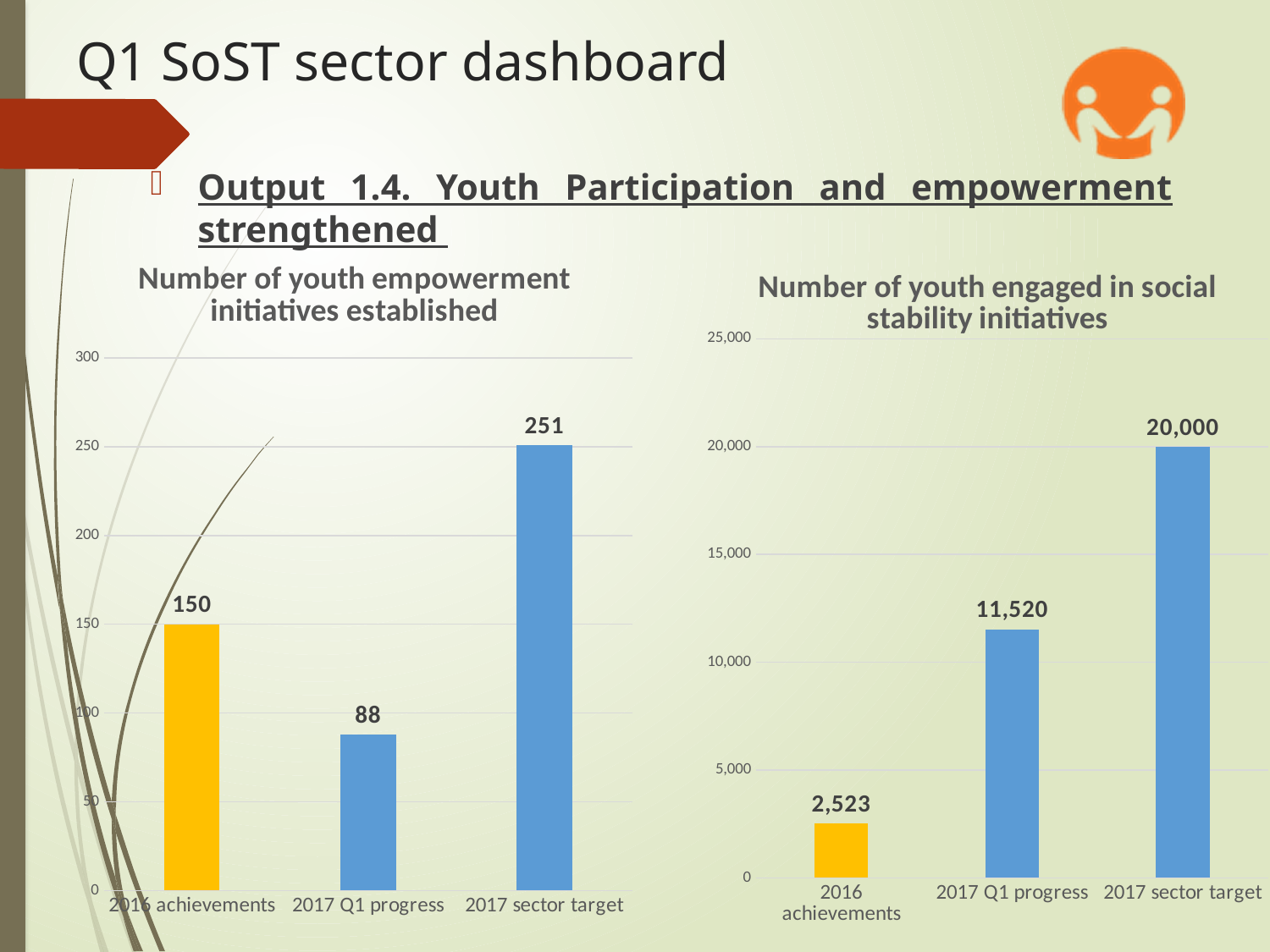
In the 'Number of youth empowerment initiatives established' chart, which category has the lowest value? 2017 Q1 progress In the 'Number of youth engaged in social stability initiatives' chart, what is the difference between the 2017 sector target and 2017 Q1 progress? 8,480 In the 'Number of youth engaged in social stability initiatives' chart, which is larger: 2016 achievements or 2017 Q1 progress? 2017 Q1 progress In the 'Number of youth empowerment initiatives established' chart, which category has the highest value? 2017 sector target In the 'Number of youth engaged in social stability initiatives' chart, what is the value for 2017 Q1 progress? 11,520 In the 'Number of youth empowerment initiatives established' chart, what is the value for 2017 Q1 progress? 88 In the 'Number of youth engaged in social stability initiatives' chart, what is the value for 2016 achievements? 2,523 How many categories are shown in the 'Number of youth engaged in social stability initiatives' chart? 3 In the 'Number of youth empowerment initiatives established' chart, what is the value for 2016 achievements? 150 In the 'Number of youth empowerment initiatives established' chart, what is the difference between the 2017 sector target and 2016 achievements? 101 In the 'Number of youth engaged in social stability initiatives' chart, what is the value for 2017 sector target? 20,000 What type of chart is the 'Number of youth empowerment initiatives established' chart? Bar chart